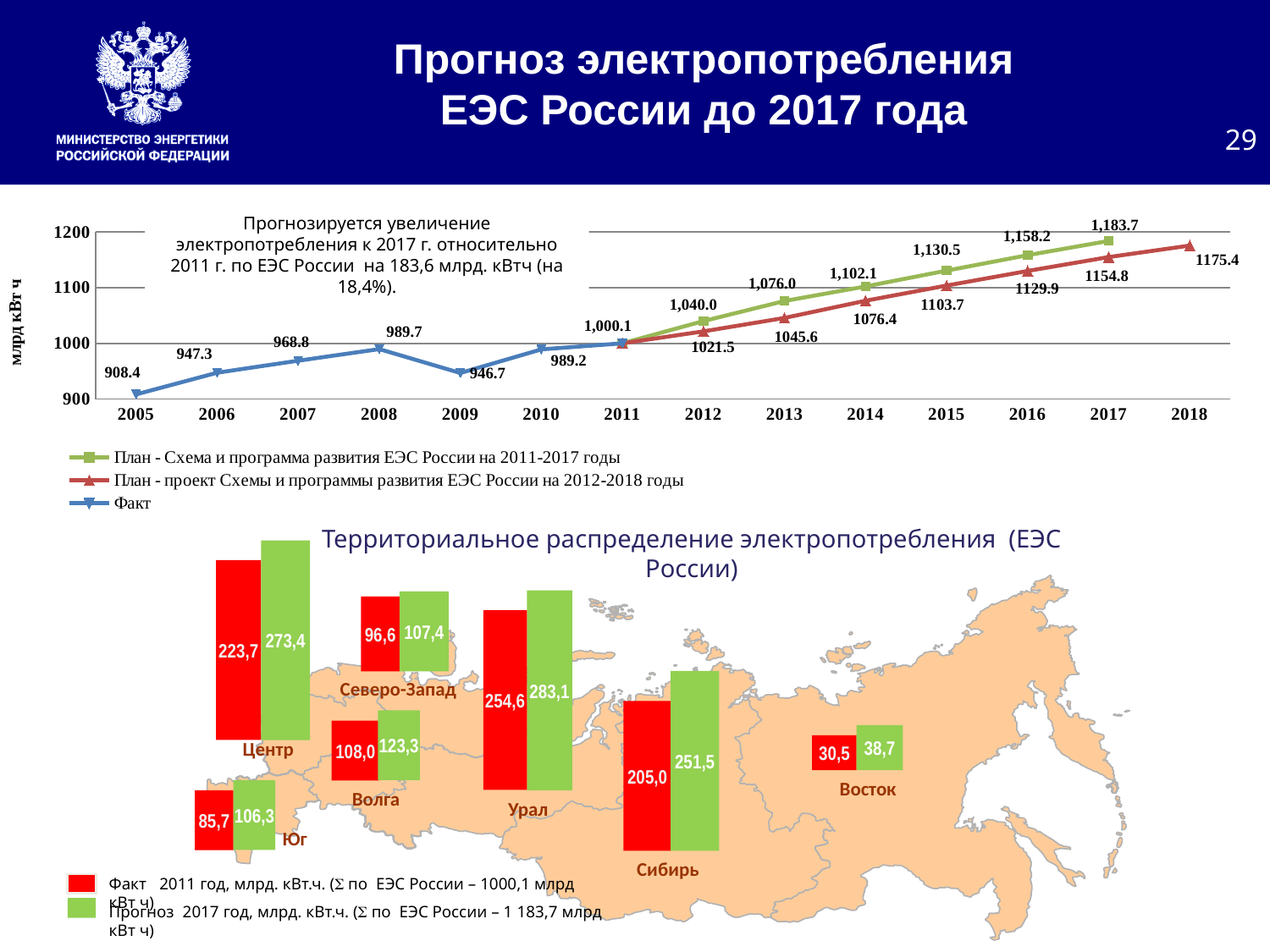
In the top line chart, which year has the lowest Факт value? 2005 In the top line chart, how many series does the legend list? 3 In the bottom chart 'Территориальное распределение электропотребления (ЕЭС России)', how many regions are shown? 7 In the top line chart, what is the 2018 value of the series 'План - проект Схемы и программы развития ЕЭС России на 2012-2018 годы'? 1175.4 In the top line chart, does the Факт series rise or fall between 2008 and 2009? fall In the bottom chart 'Территориальное распределение электропотребления (ЕЭС России)', which region has the highest Прогноз 2017 value? Урал In the bottom chart 'Территориальное распределение электропотребления (ЕЭС России)', which region has the lowest Факт 2011 value? Восток In the top line chart, what is the 2017 value of the series 'План - Схема и программа развития ЕЭС России на 2011-2017 годы'? 1,183.7 In the bottom chart 'Территориальное распределение электропотребления (ЕЭС России)', what is the Факт 2011 value for Сибирь? 205,0 What type of chart is the top chart on the slide? line chart In the top line chart, what is the value of the Факт series for 2008? 989.7 In the top line chart, what is the difference between the 2015 values of the two plan series (1,130.5 and 1103.7)? 26.8